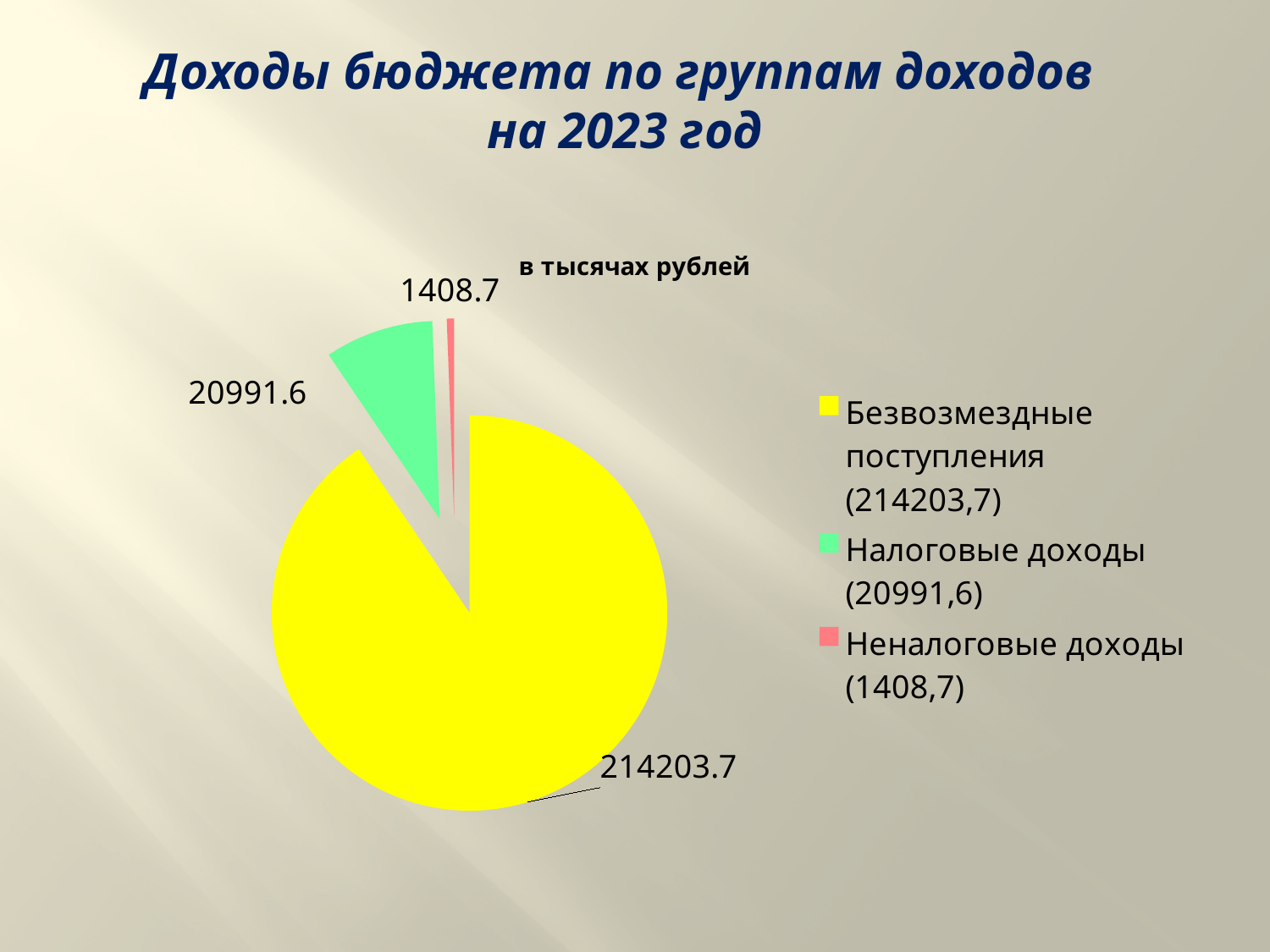
How many slices does the pie chart have? 3 What is the value for Налоговые доходы? 20991.6 What is the value for Неналоговые доходы? 1408.7 Which is larger, Налоговые доходы or Неналоговые доходы? Налоговые доходы What is the difference between Налоговые доходы and Неналоговые доходы? 19582.9 What is the difference between Безвозмездные поступления and Налоговые доходы? 193212.1 Which category has the smallest slice of the pie? Неналоговые доходы What type of chart is shown on the slide? pie chart What unit is stated in the chart title above the pie? в тысячах рублей What is the value for Безвозмездные поступления? 214203.7 What colour is the slice for Налоговые доходы? green Which category has the largest slice of the pie? Безвозмездные поступления